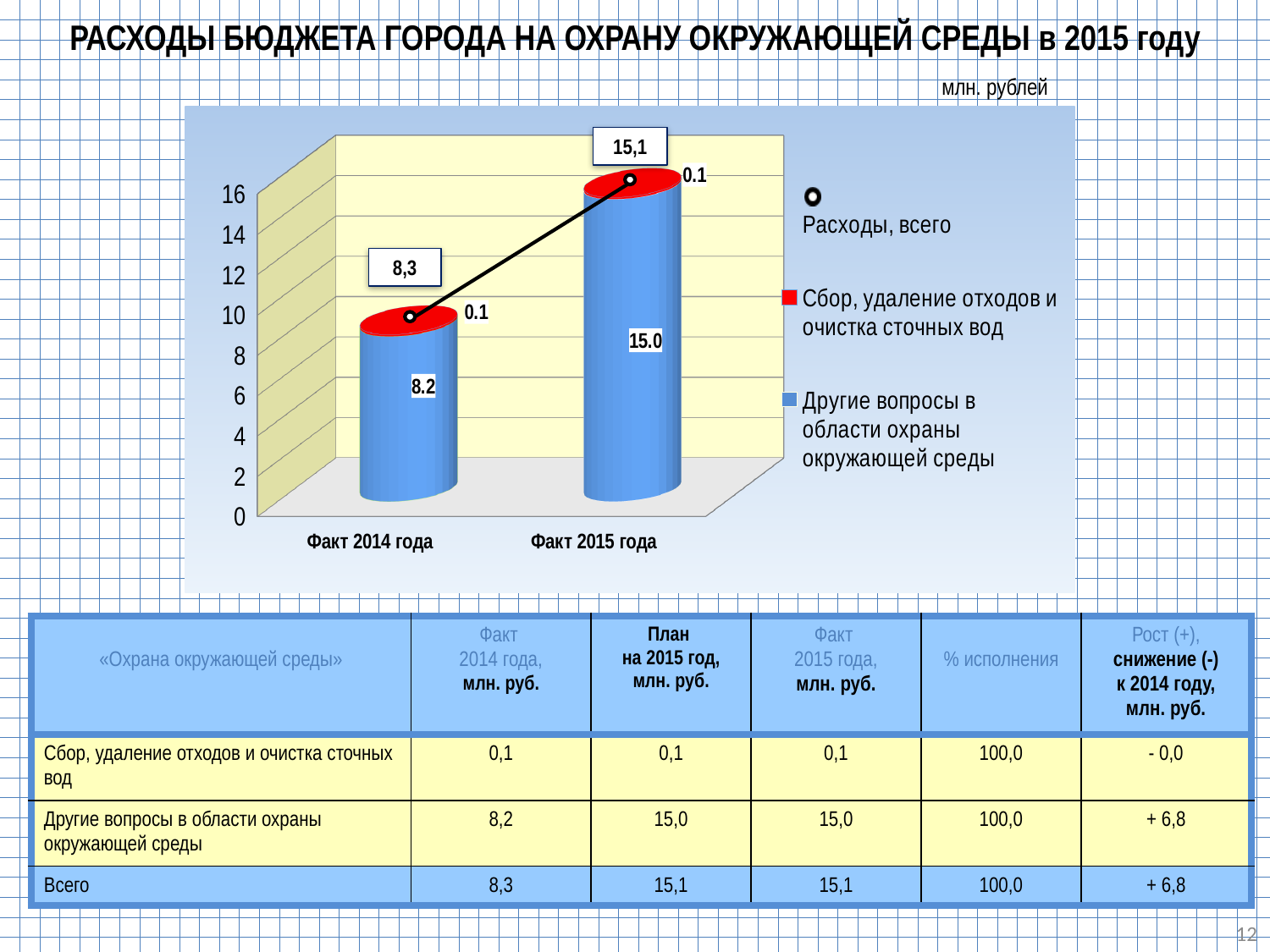
How many categories are shown on the x axis of the chart? 2 What kind of chart is shown on the slide? Stacked bar chart with a line Does the 'Расходы, всего' line rise or fall from Факт 2014 года to Факт 2015 года? Rise What is the value of the 'Другие вопросы в области охраны окружающей среды' series for Факт 2014 года? 8.2 What is the value of the 'Другие вопросы в области охраны окружающей среды' series for Факт 2015 года? 15.0 What is the value of 'Расходы, всего' for Факт 2015 года? 15,1 What is the value of 'Сбор, удаление отходов и очистка сточных вод' for Факт 2014 года? 0.1 Which category has the higher total expenditure ('Расходы, всего')? Факт 2015 года By how much does 'Расходы, всего' for Факт 2015 года exceed that for Факт 2014 года? 6,8 What is the value of 'Расходы, всего' for Факт 2014 года? 8,3 Which is larger: 'Другие вопросы в области охраны окружающей среды' for Факт 2014 года or for Факт 2015 года? Факт 2015 года How many series does the chart legend list? 3